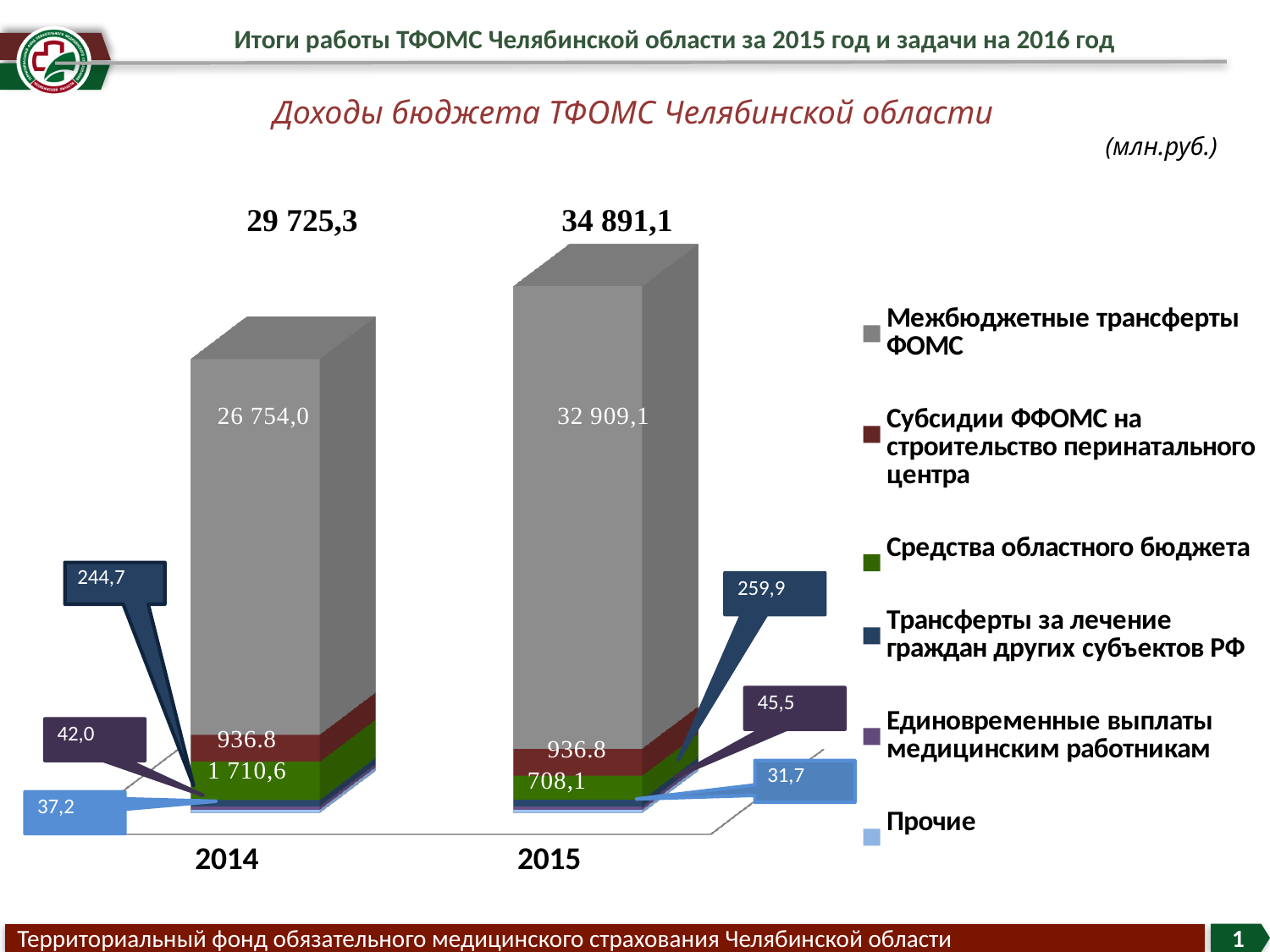
What is the difference between the Межбюджетные трансферты ФОМС values for 2015 and 2014? 6 155,1 What unit is stated for the values in the chart? млн.руб. What is the value of Прочие for 2014? 37,2 What is the value of Средства областного бюджета for 2014? 1 710,6 What kind of chart is shown on the slide? Stacked bar chart What is the total of the stacked bar for 2015? 34 891,1 What is the value of Трансферты за лечение граждан других субъектов РФ for 2015? 259,9 What is the value of Межбюджетные трансферты ФОМС for 2015? 32 909,1 Which year has the larger value for Средства областного бюджета, 2014 or 2015? 2014 How many series does the legend list? 6 What is the difference between the total for 2015 and the total for 2014? 5 165,8 Which series has the highest value in 2014? Межбюджетные трансферты ФОМС